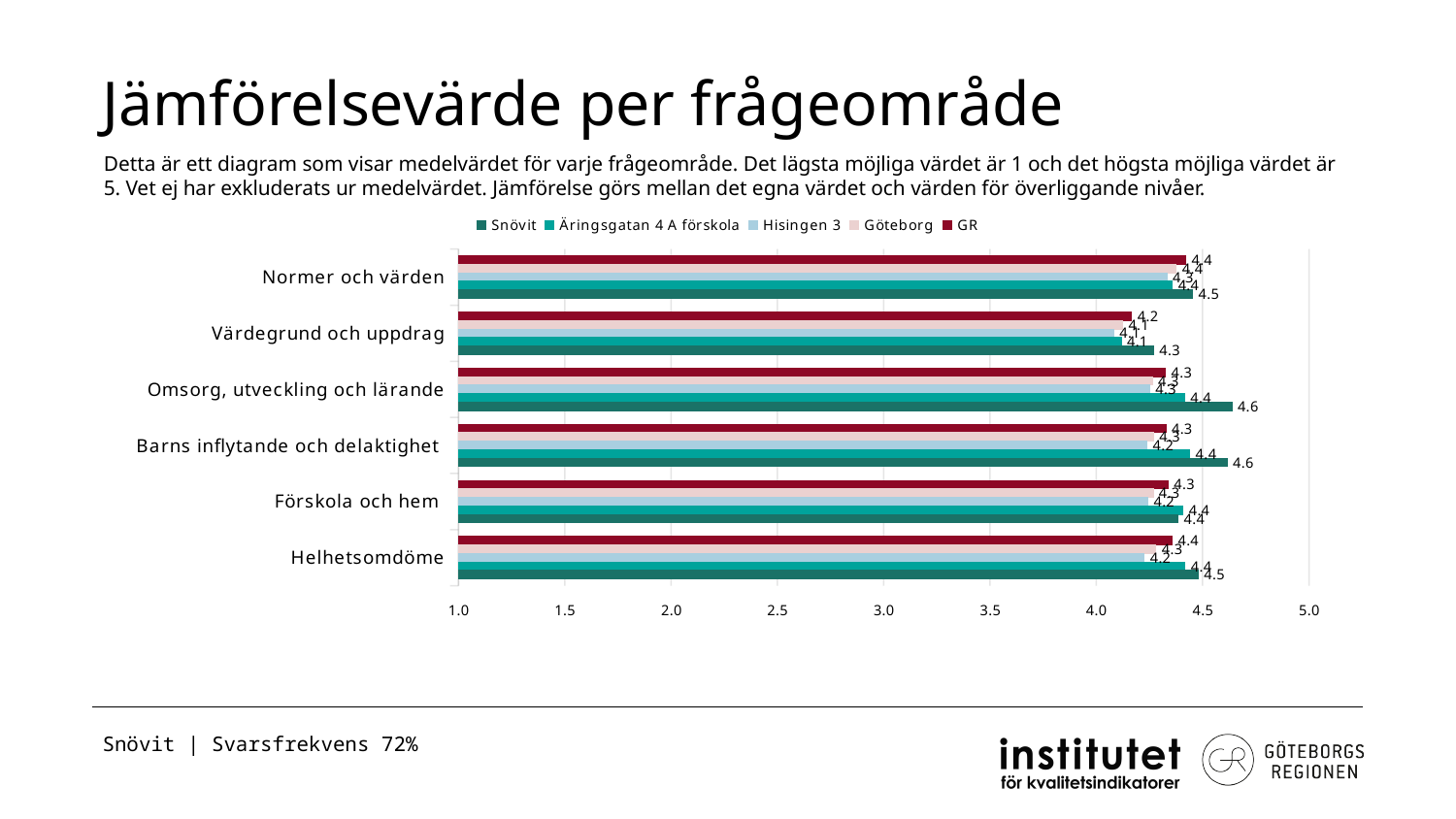
In which question area does Snövit have its lowest value? Värdegrund och uppdrag How many question areas (categories) are shown on the y axis? 6 What is the value for Snövit in 'Normer och värden'? 4.5 What is the value for Snövit in 'Omsorg, utveckling och lärande'? 4.6 How many series does the legend list? 5 Which is larger for Snövit: 'Barns inflytande och delaktighet' or 'Förskola och hem'? Barns inflytande och delaktighet What is the value for Snövit in 'Värdegrund och uppdrag'? 4.3 What is the difference between Snövit's value in 'Omsorg, utveckling och lärande' and in 'Värdegrund och uppdrag'? 0.3 What is the value for Snövit in 'Förskola och hem'? 4.4 What type of chart is shown on the slide? bar chart What is the title of the chart slide? Jämförelsevärde per frågeområde Is the value for Snövit in 'Barns inflytande och delaktighet' greater or less than 4.5? greater